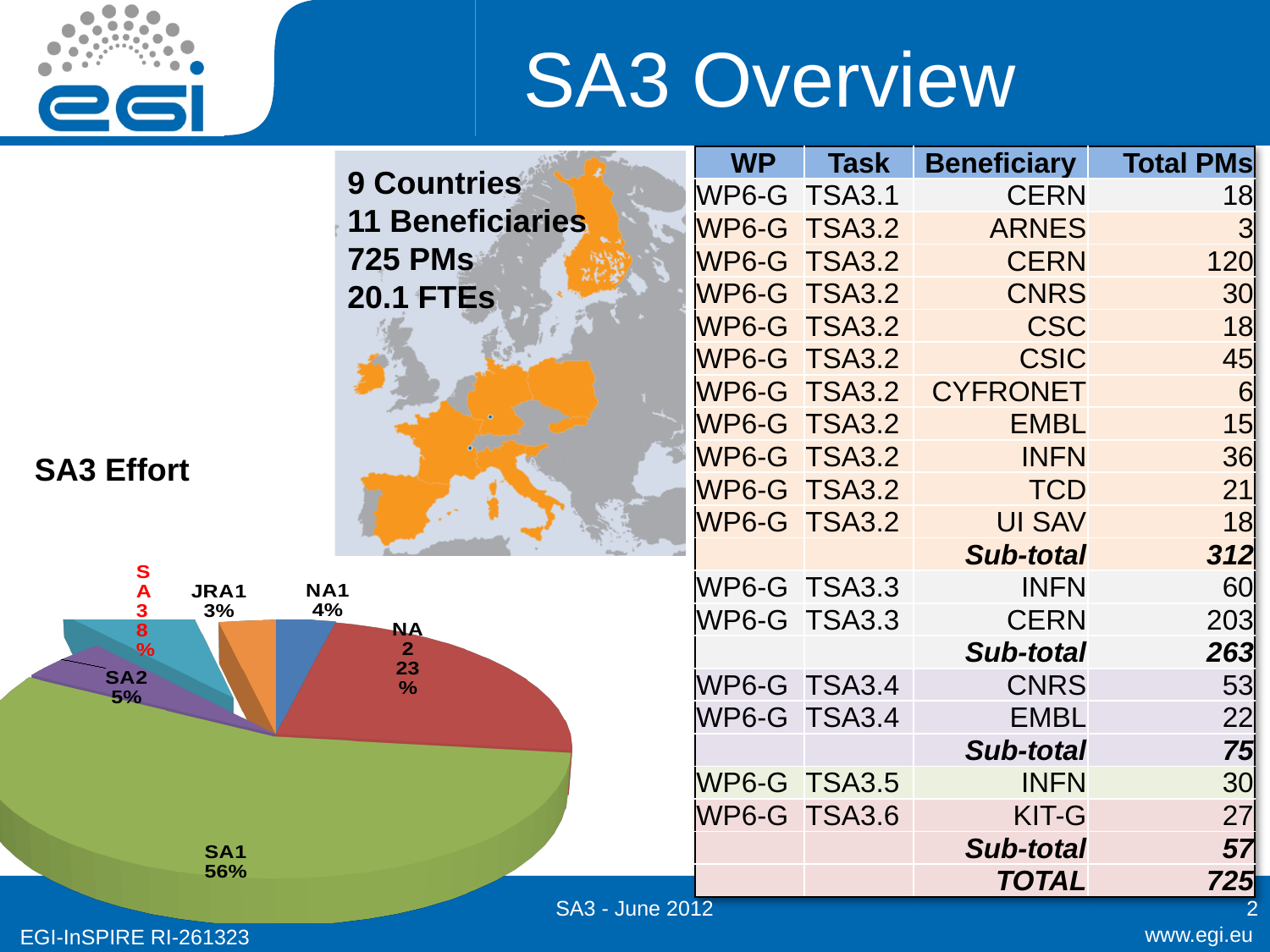
What share of the pie does SA1 have? 56% What share of the pie does NA1 have? 4% What is the title of the pie chart? SA3 Effort What share of the pie does NA2 have? 23% Which slice of the pie is the smallest? JRA1 What is the difference in percentage points between SA1 and NA2? 33 What kind of chart is shown on the slide? pie chart Which is larger, the SA2 slice or the NA1 slice? SA2 How many slices does the pie chart have? 6 What share of the pie does SA3 have? 8% Which slice of the pie is the largest? SA1 What share of the pie does JRA1 have? 3%